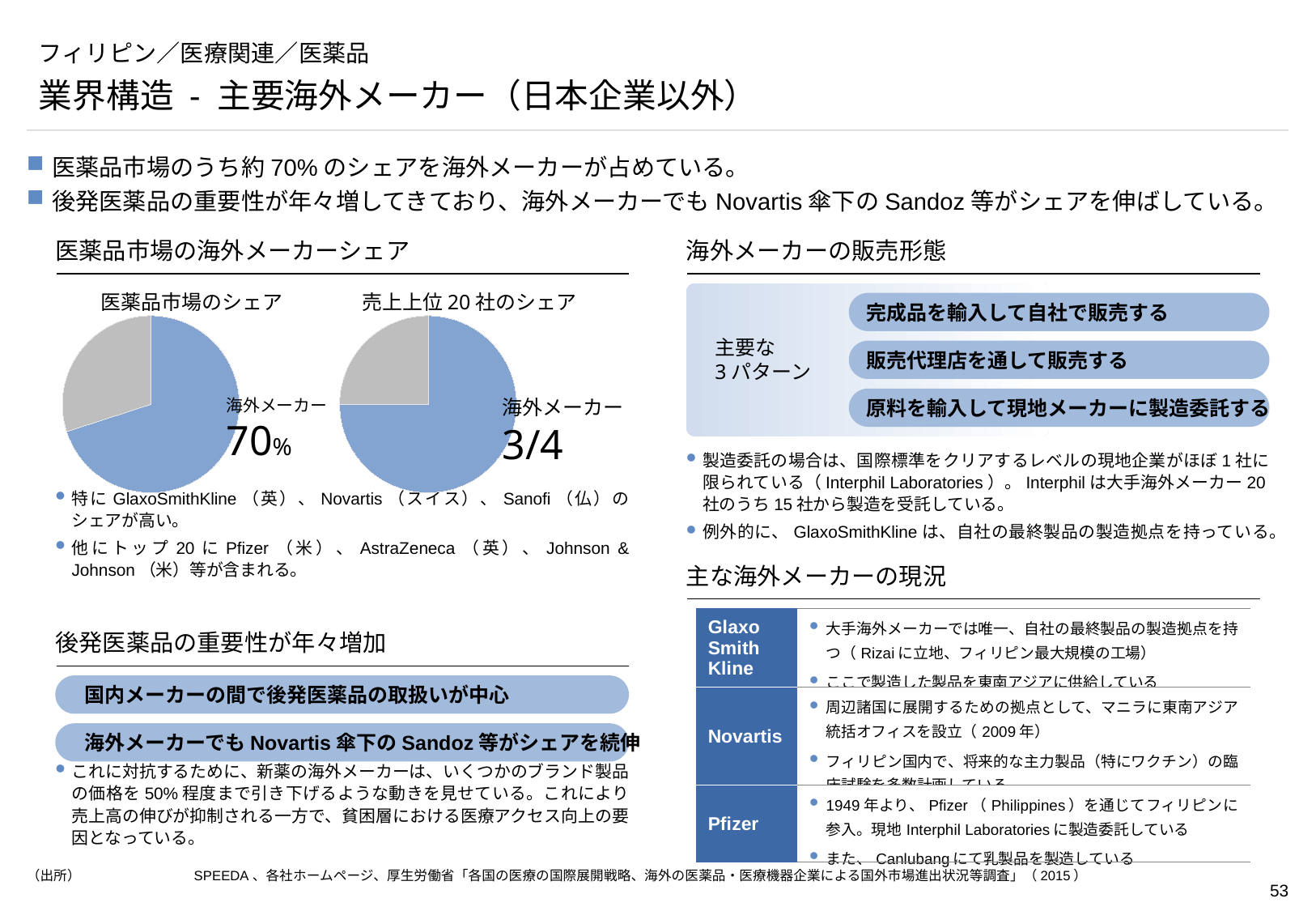
In the pie chart titled 医薬品市場のシェア, which slice is larger, the blue 海外メーカー slice or the grey slice? 海外メーカー (blue) What kind of chart is used for 医薬品市場のシェア? Pie chart Is the 海外メーカー share in the pie chart titled 医薬品市場のシェア greater or less than 50%? greater In the pie chart titled 売上上位20社のシェア, which slice is larger, the blue 海外メーカー slice or the grey slice? 海外メーカー (blue) What kind of chart is used for 売上上位20社のシェア? Pie chart How many slices does the pie chart titled 売上上位20社のシェア have? 2 How many slices does the pie chart titled 医薬品市場のシェア have? 2 In the pie chart titled 売上上位20社のシェア, what share is shown for 海外メーカー? 3/4 What colour is the 海外メーカー slice in the pie chart titled 医薬品市場のシェア? Blue How many pie charts are shown on the slide? 2 In the pie chart titled 医薬品市場のシェア, what share is shown for 海外メーカー? 70%